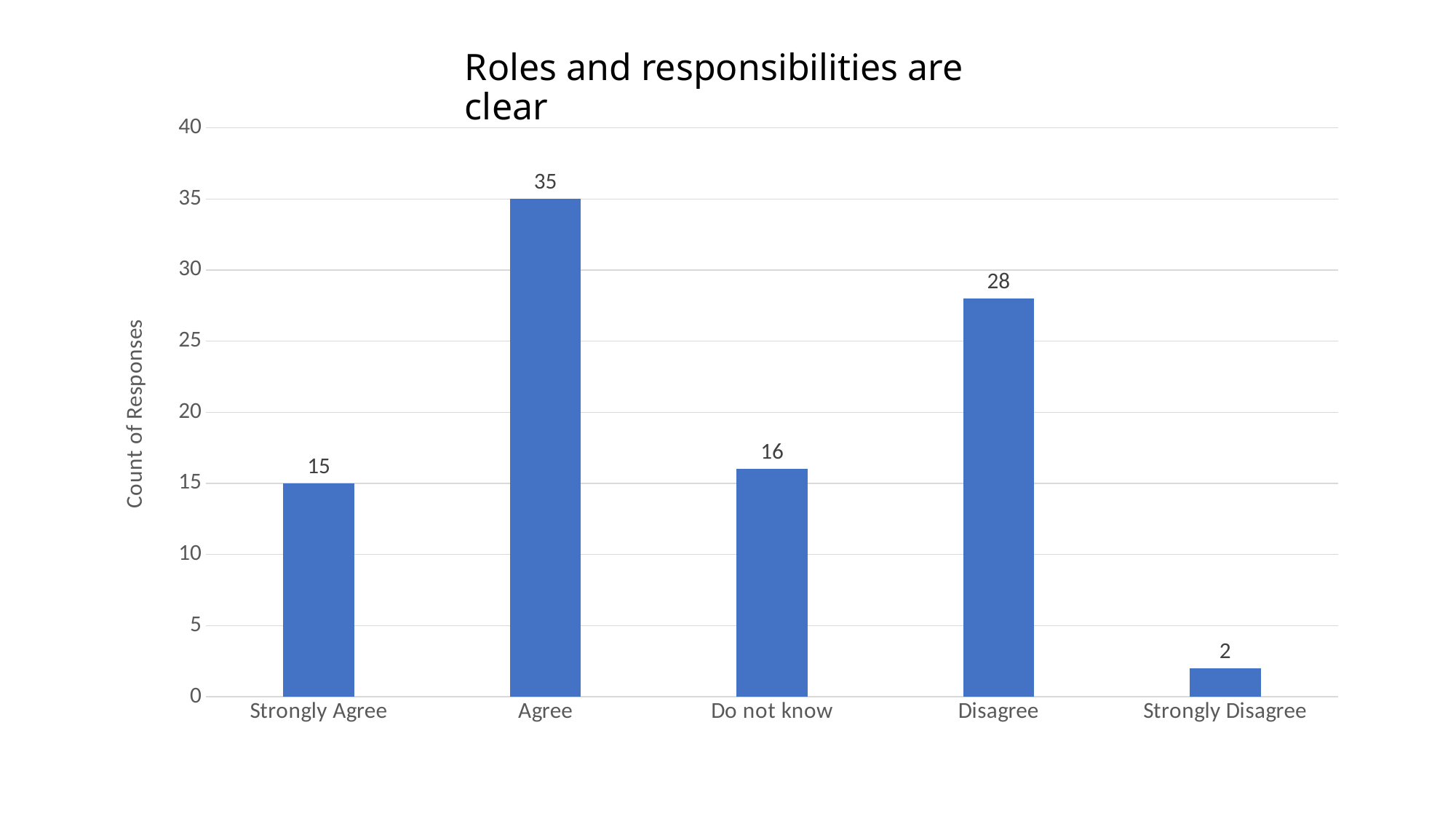
How many categories are shown on the x axis? 5 What is the count of responses for Do not know? 16 Which category has the lowest count of responses? Strongly Disagree What is the difference between the counts for Agree and Disagree? 7 What kind of chart is shown on the slide? Bar chart Which has a higher count of responses, Disagree or Strongly Agree? Disagree Is the value for Disagree greater or less than 25? greater What is the title of the chart? Roles and responsibilities are clear What is the difference between the counts for Strongly Agree and Strongly Disagree? 13 What is the count of responses for Strongly Disagree? 2 What is the count of responses for Agree? 35 Which category has the highest count of responses? Agree